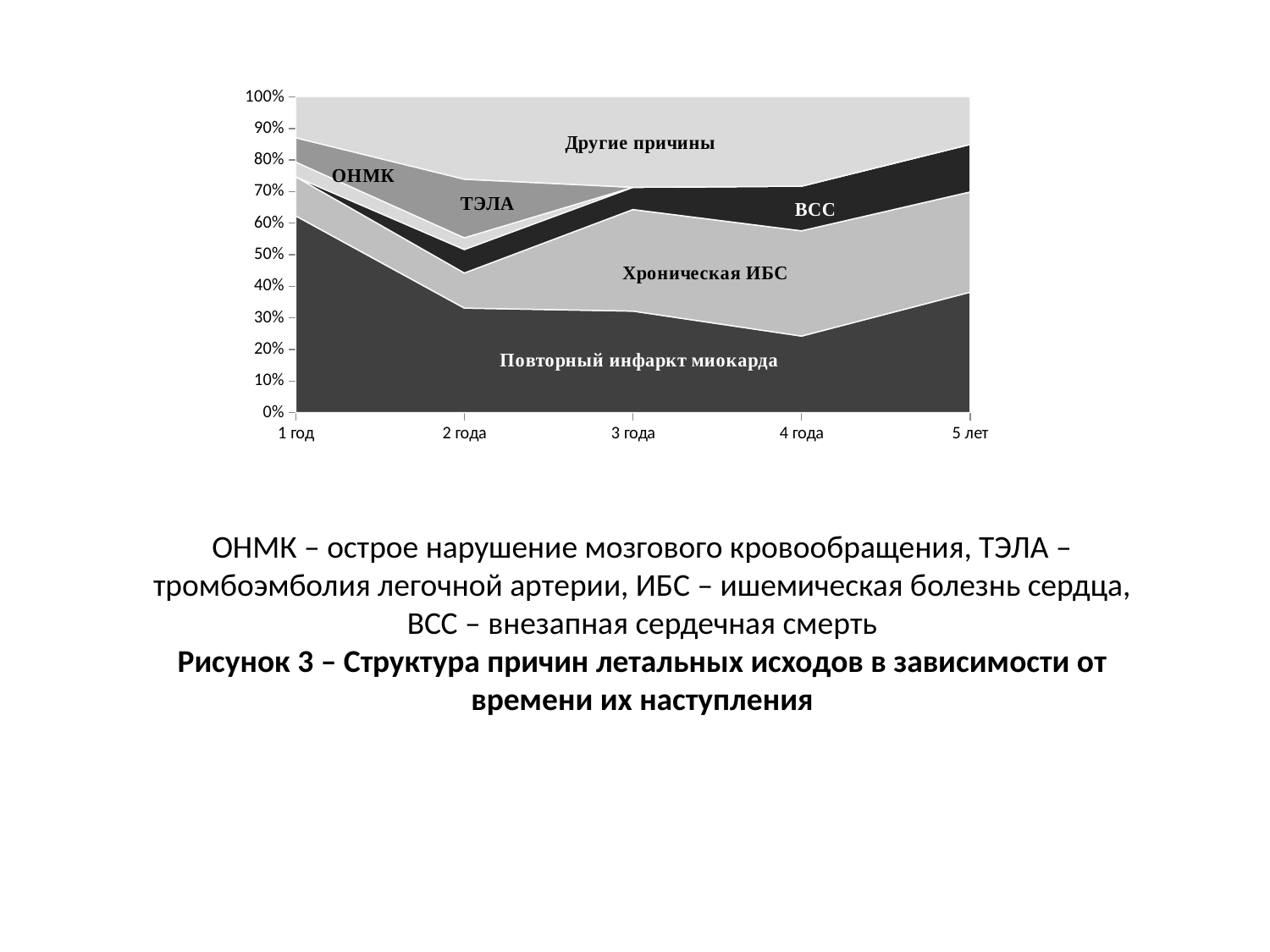
Does the share of Повторный инфаркт миокарда rise or fall from 1 год to 4 года? fall Which cause of death occupies the bottom area of the chart? Повторный инфаркт миокарда What kind of chart is shown on the slide? Stacked area chart Is the share of Повторный инфаркт миокарда at 1 год greater or less than 50%? greater Is the share of Повторный инфаркт миокарда at 4 года greater or less than 30%? less Is the share of Повторный инфаркт миокарда larger at 1 год or at 5 лет? 1 год How many time points are shown on the x axis of the chart? 5 At which time point is the share of Повторный инфаркт миокарда the highest? 1 год Is the share of Повторный инфаркт миокарда at 5 лет greater or less than 30%? greater At which time point is the share of Повторный инфаркт миокарда the lowest? 4 года How many causes of death (series) are labelled in the chart? 6 Which cause of death occupies the top area of the chart? Другие причины